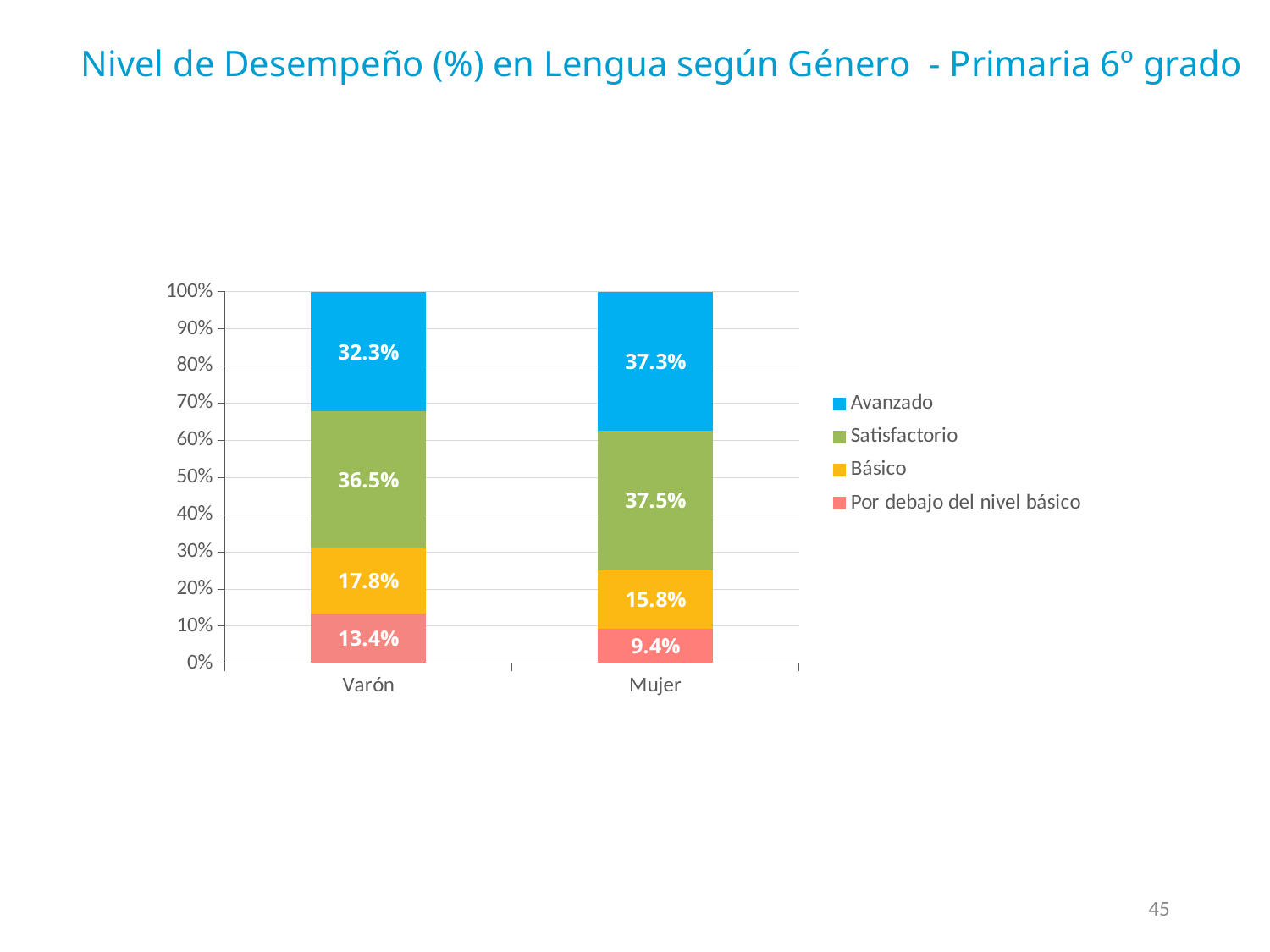
Which category has the higher Avanzado value, Varón or Mujer? Mujer What is the Por debajo del nivel básico value for Mujer? 9.4% What is the difference between the Básico values for Varón and Mujer? 2.0% How many series does the legend list? 4 What is the Básico value for Varón? 17.8% Which category has the lower Por debajo del nivel básico value? Mujer What kind of chart is shown on the slide? Stacked bar chart How many categories are shown on the x axis? 2 Which series is shown in blue in the legend? Avanzado What is the Avanzado value for Varón? 32.3% What is the Satisfactorio value for Mujer? 37.5% What is the difference between the Avanzado values for Mujer and Varón? 5.0%